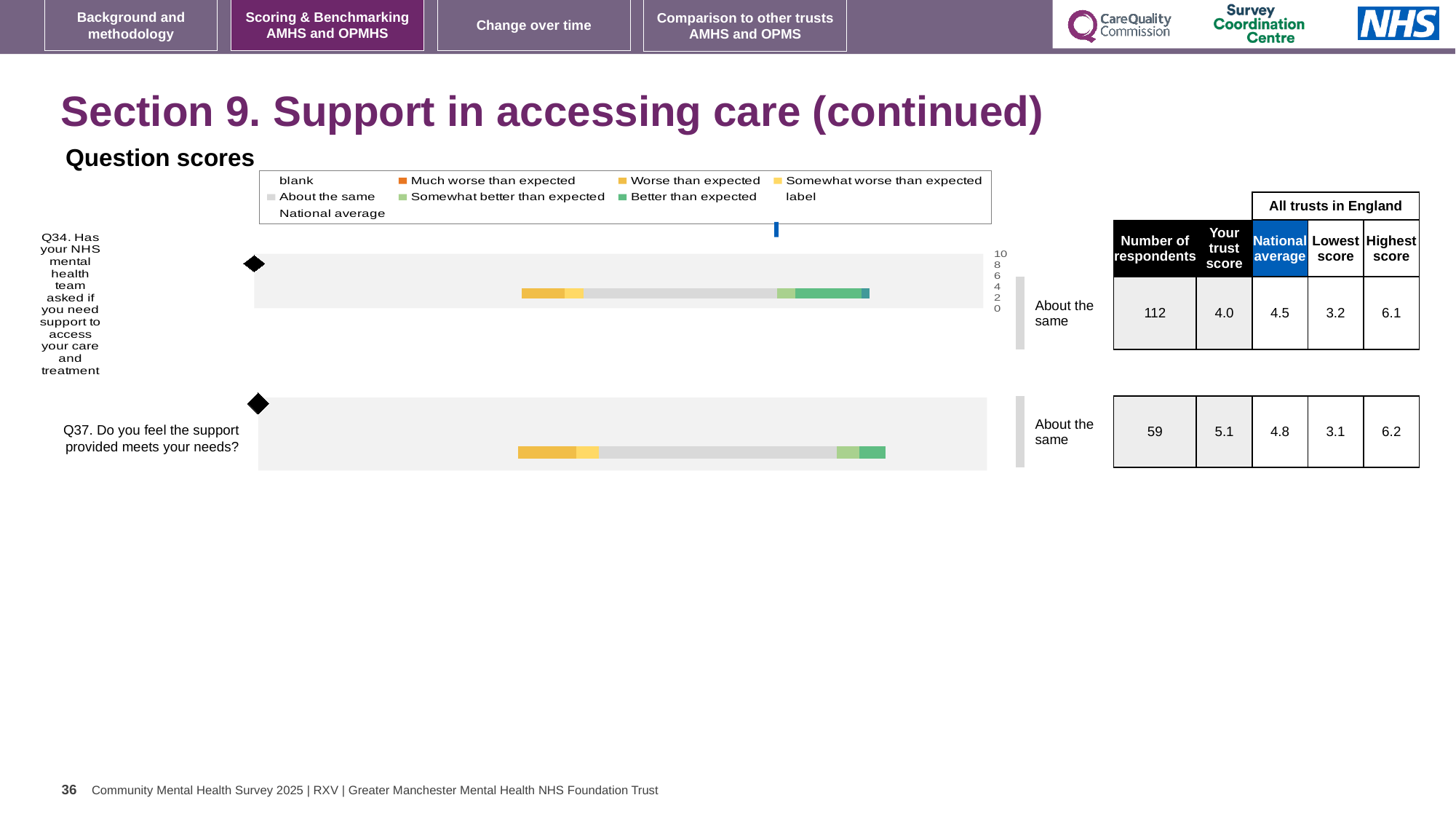
What is the number of respondents for Q34 in the question scores table? 112 What is the highest score among all trusts in England for Q37? 6.2 How many questions are plotted in the question scores chart? 2 What kind of chart is used to show the question scores for Q34 and Q37? bar chart What is the difference between the highest and lowest scores for Q34? 2.9 Which question has more respondents, Q34 or Q37? Q34 What is the national average score for Q34? 4.5 What is the title shown above the chart? Question scores What is the lowest score among all trusts in England for Q34? 3.2 For Q37, which is larger: the trust score or the national average? the trust score What benchmark category is shown next to the Q34 bar? About the same What is the trust score for Q37 (Do you feel the support provided meets your needs?)? 5.1